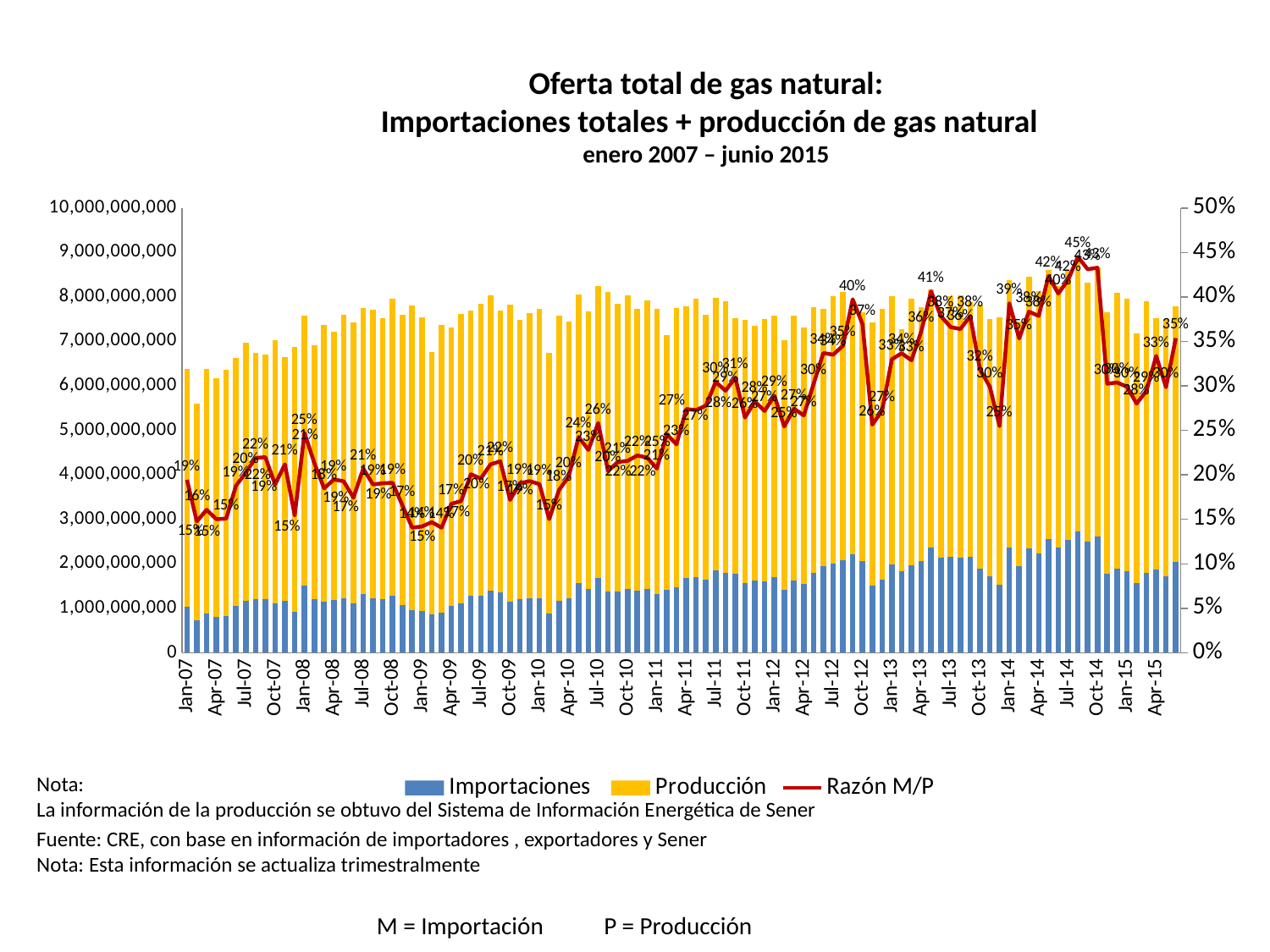
What is the value of Razón M/P at the last point of the line (mid-2015)? 35% What is the highest value reached by the Razón M/P line? 45% Is the Importaciones value for Jul-14 greater or less than 2,000,000,000? greater What period does the chart cover according to the subtitle? enero 2007 – junio 2015 What is the value of Razón M/P at Jan-07, the first point of the line? 19% Does the Razón M/P line generally rise or fall from 2007 to 2015? Rise How many series does the legend list? 3 What is the lowest value reached by the Razón M/P line? 14% What kind of chart is shown on the slide? A combination chart: stacked bar chart with a line Is the Razón M/P value larger at Jan-07 or at the last point of the line in 2015? At the last point in 2015 What is the difference between the highest (45%) and lowest (14%) values of the Razón M/P line? 31 percentage points What is the title of the chart? Oferta total de gas natural: Importaciones totales + producción de gas natural